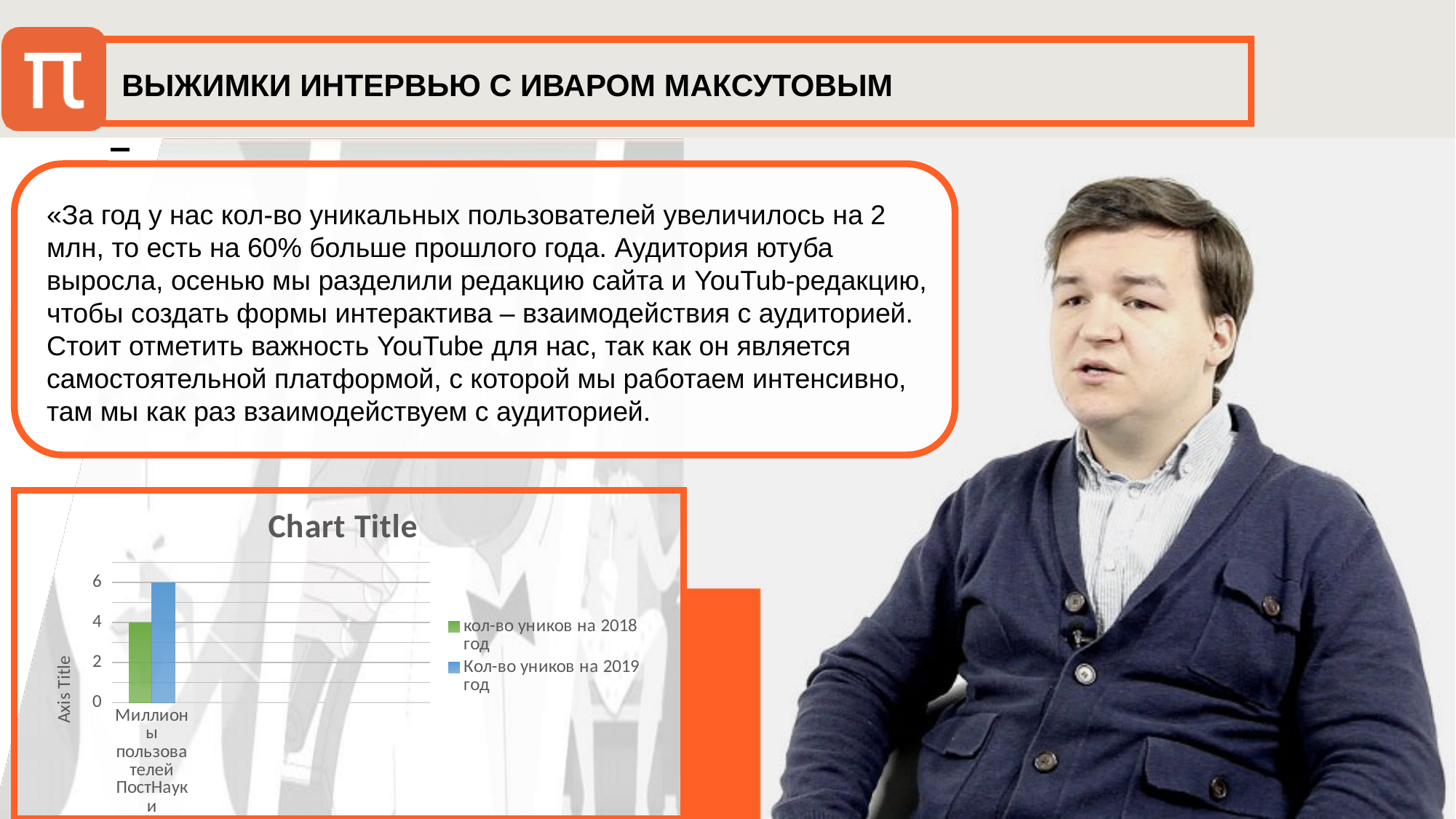
What is the difference between the 2019 and 2018 values? 2 What kind of chart is shown on the slide? bar chart How many series does the chart legend list? 2 What is the value for "Кол-во уников на 2019 год"? 6 Is the value for "Кол-во уников на 2019 год" greater or less than 4? greater Is the value for "кол-во уников на 2018 год" greater or less than 6? less Which series has the lowest value in the chart? кол-во уников на 2018 год How many categories are shown on the x axis of the chart? 1 What is the value for "кол-во уников на 2018 год"? 4 What is the title of the chart? Chart Title Which series has the higher value, "кол-во уников на 2018 год" or "Кол-во уников на 2019 год"? Кол-во уников на 2019 год What colour is the bar for "Кол-во уников на 2019 год"? blue